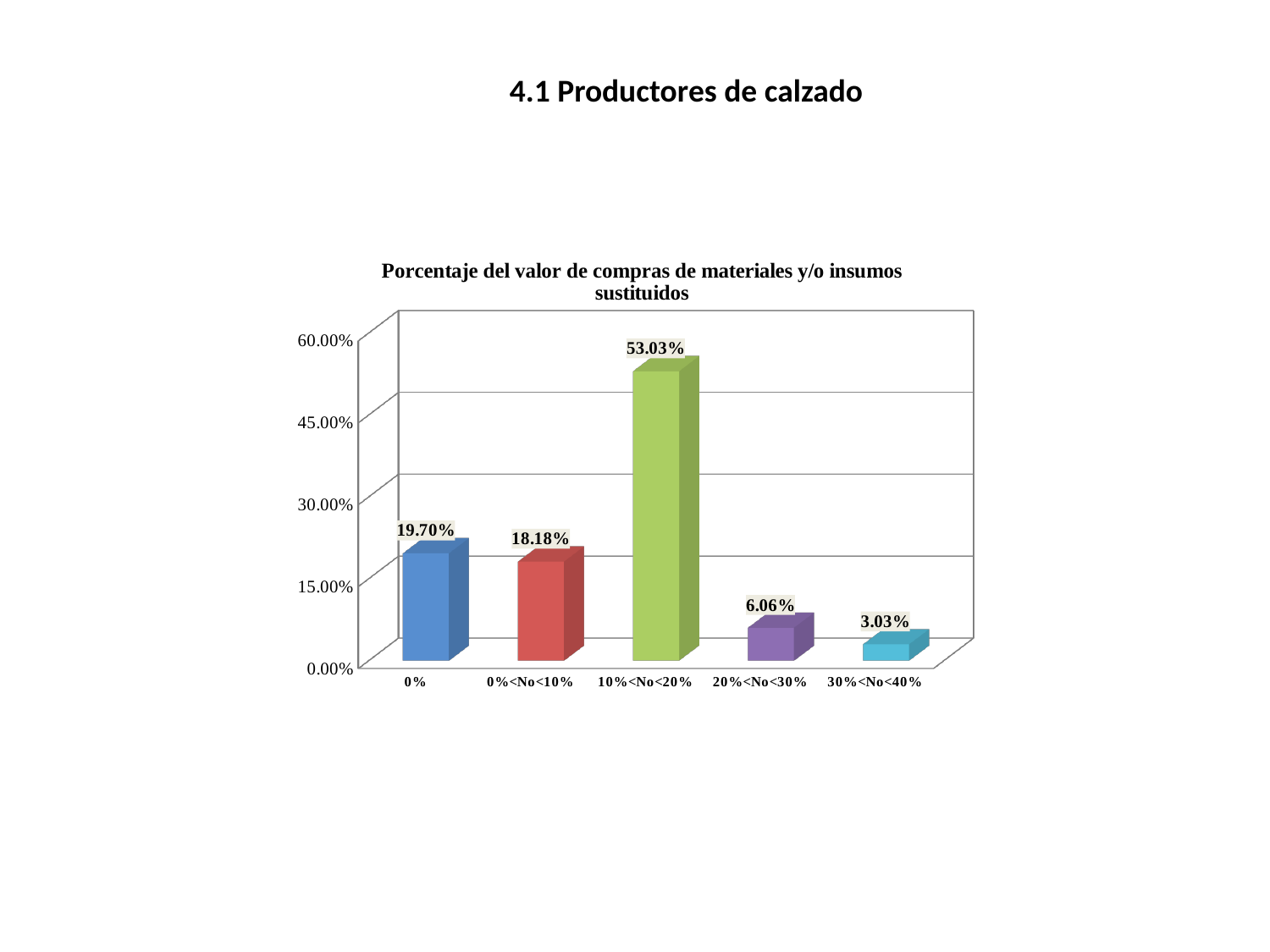
What is the value for the 20%<No<30% category? 6.06% What is the value for the 0% category? 19.70% What is the difference between the values for 20%<No<30% and 30%<No<40%? 3.03% Which category has the highest value? 10%<No<20% Is the value for 10%<No<20% greater or less than 45.00%? greater What is the difference between the values for 10%<No<20% and 0%<No<10%? 34.85% What is the value for the 10%<No<20% category? 53.03% Which is larger, the value for 0% or the value for 0%<No<10%? 0% How many categories are shown on the x axis? 5 Which category has the lowest value? 30%<No<40% What kind of chart is shown on the slide? bar chart What is the value for the 30%<No<40% category? 3.03%